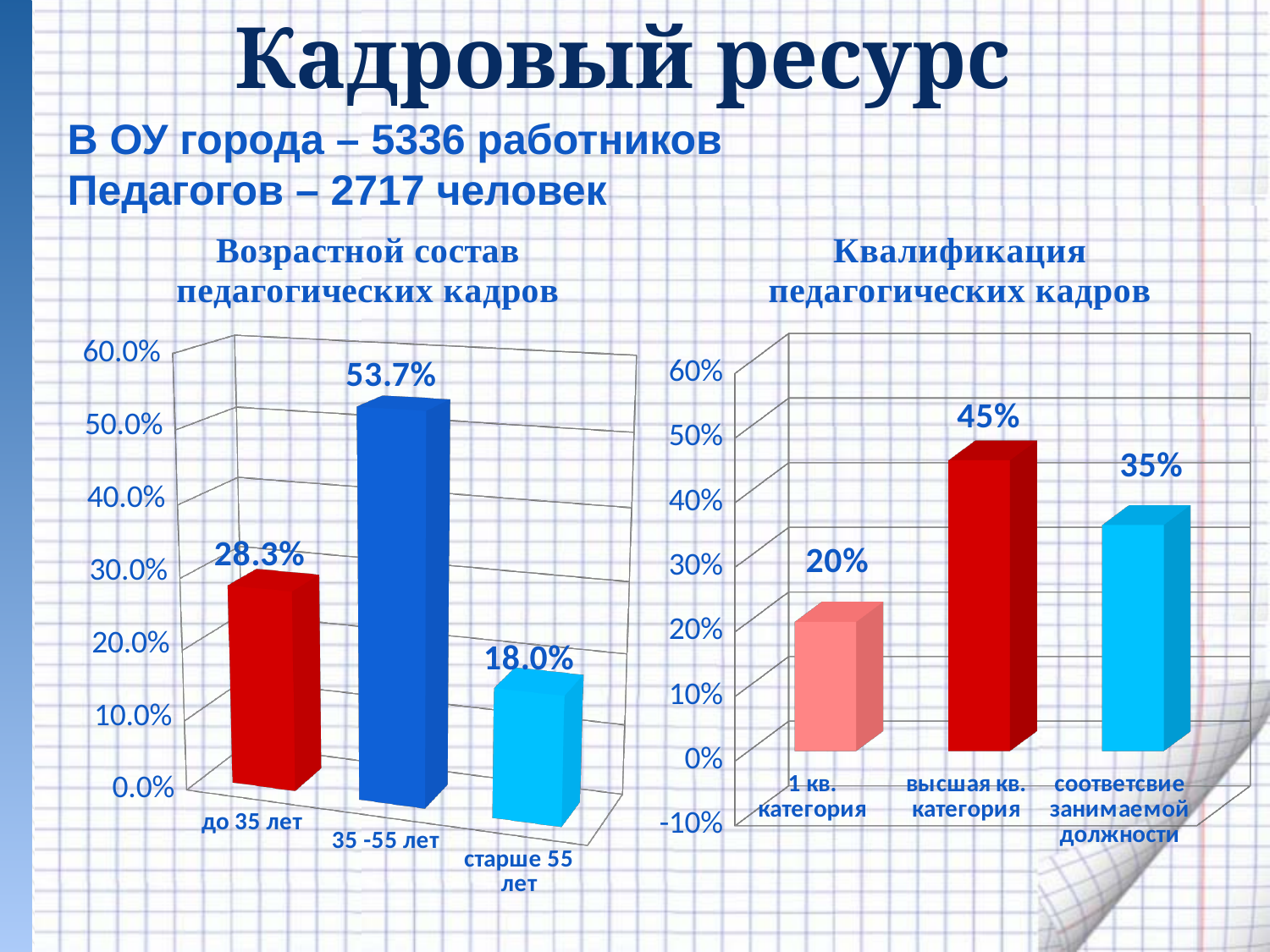
In the chart 'Квалификация педагогических кадров', which category has the highest value? высшая кв. категория In the chart 'Возрастной состав педагогических кадров', which category has the lowest value? старше 55 лет In the chart 'Возрастной состав педагогических кадров', what is the value for '35 -55 лет'? 53.7% In the chart 'Квалификация педагогических кадров', what is the value for 'высшая кв. категория'? 45% In the chart 'Квалификация педагогических кадров', what is the value for '1 кв. категория'? 20% In the chart 'Возрастной состав педагогических кадров', what is the difference between the values for '35 -55 лет' and 'до 35 лет'? 25.4% What kind of chart is 'Квалификация педагогических кадров'? bar chart In the chart 'Квалификация педагогических кадров', which is larger: 'соответсвие занимаемой должности' or '1 кв. категория'? соответсвие занимаемой должности In the chart 'Возрастной состав педагогических кадров', how many categories are shown? 3 In the chart 'Возрастной состав педагогических кадров', what is the value for 'до 35 лет'? 28.3% In the chart 'Квалификация педагогических кадров', what is the difference between the values for 'высшая кв. категория' and 'соответсвие занимаемой должности'? 10% What is the title of the chart on the left side of the slide? Возрастной состав педагогических кадров